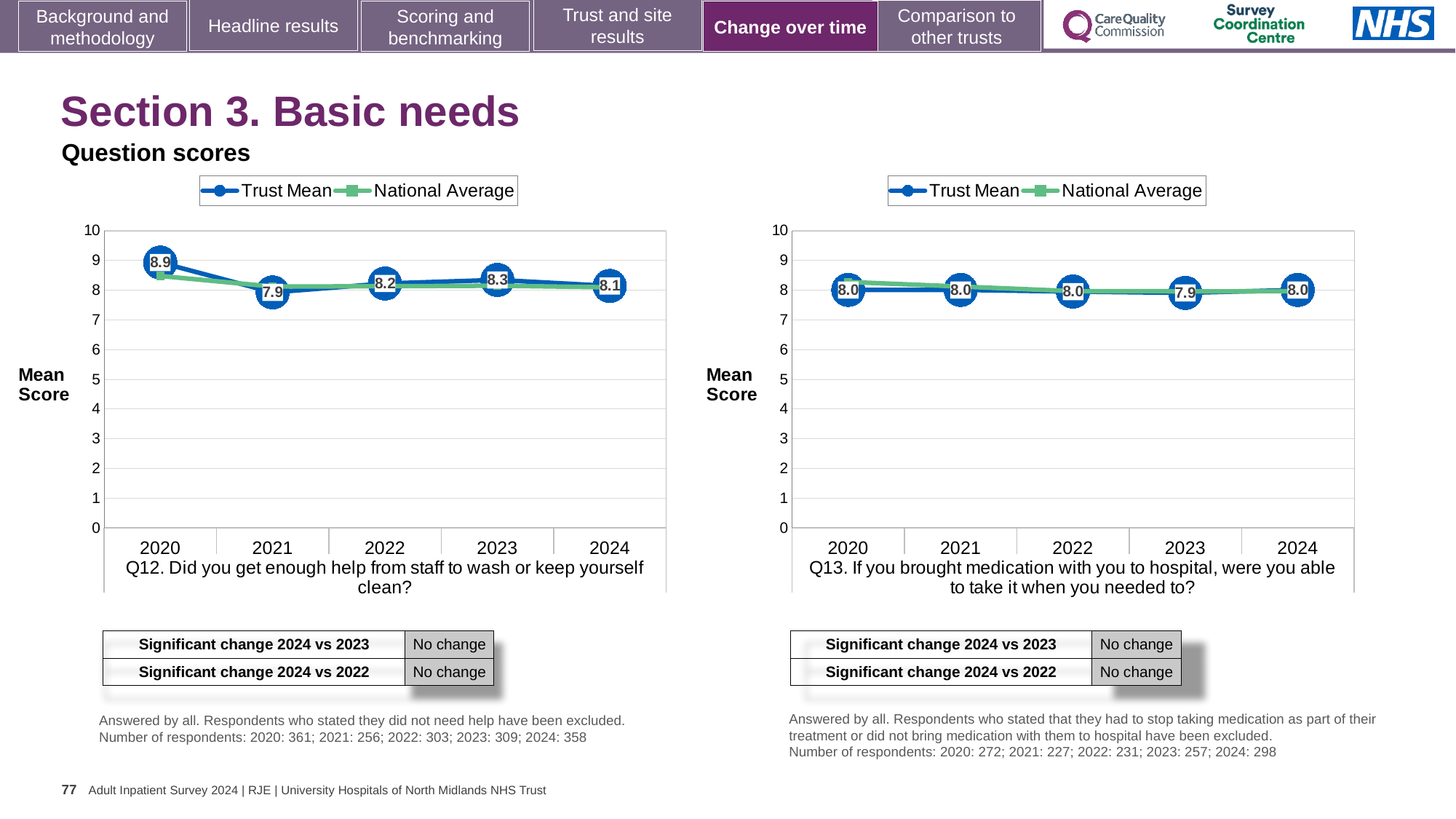
In the Q13 chart on the right, which year has the lowest Trust Mean score? 2023 In the Q13 chart on the right, what is the Trust Mean score for 2023? 7.9 In the Q12 chart on the left, which year has the highest Trust Mean score? 2020 How many years are plotted on the x axis of the Q13 chart on the right? 5 In the Q12 chart on the left, what is the difference between the Trust Mean scores for 2020 and 2021? 1.0 In the Q12 chart on the left, which year has the lowest Trust Mean score? 2021 In the Q12 chart on the left, does the Trust Mean rise or fall from 2020 to 2021? fall In the Q12 chart on the left, is the Trust Mean score higher in 2022 or 2023? 2023 In the Q12 chart on the left, what is the Trust Mean score for 2024? 8.1 In the Q13 chart on the right, what is the difference between the Trust Mean scores for 2022 and 2023? 0.1 How many series does the legend of the Q12 chart on the left list? 2 In the Q12 chart on the left, what is the Trust Mean score for 2020? 8.9